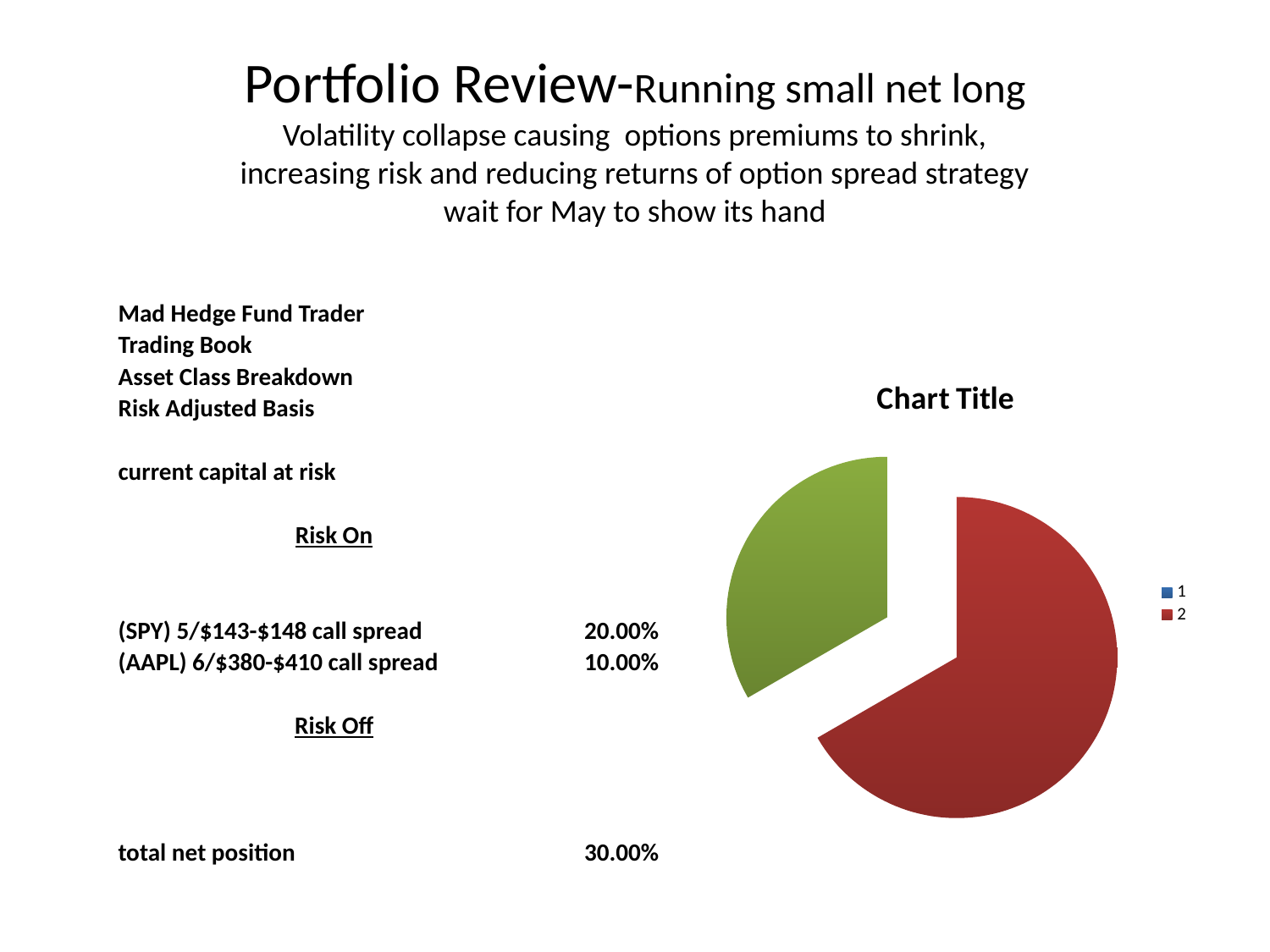
What colour is the largest slice of the pie chart? red Which slice of the pie chart is larger, the red slice or the green slice? the red slice What kind of chart is shown on the slide? pie chart What colour is the smallest slice of the pie chart? green How many slices does the pie chart have? 2 What are the entries listed in the chart's legend? 1 and 2 How many entries does the chart's legend list? 2 What is the title of the chart? Chart Title